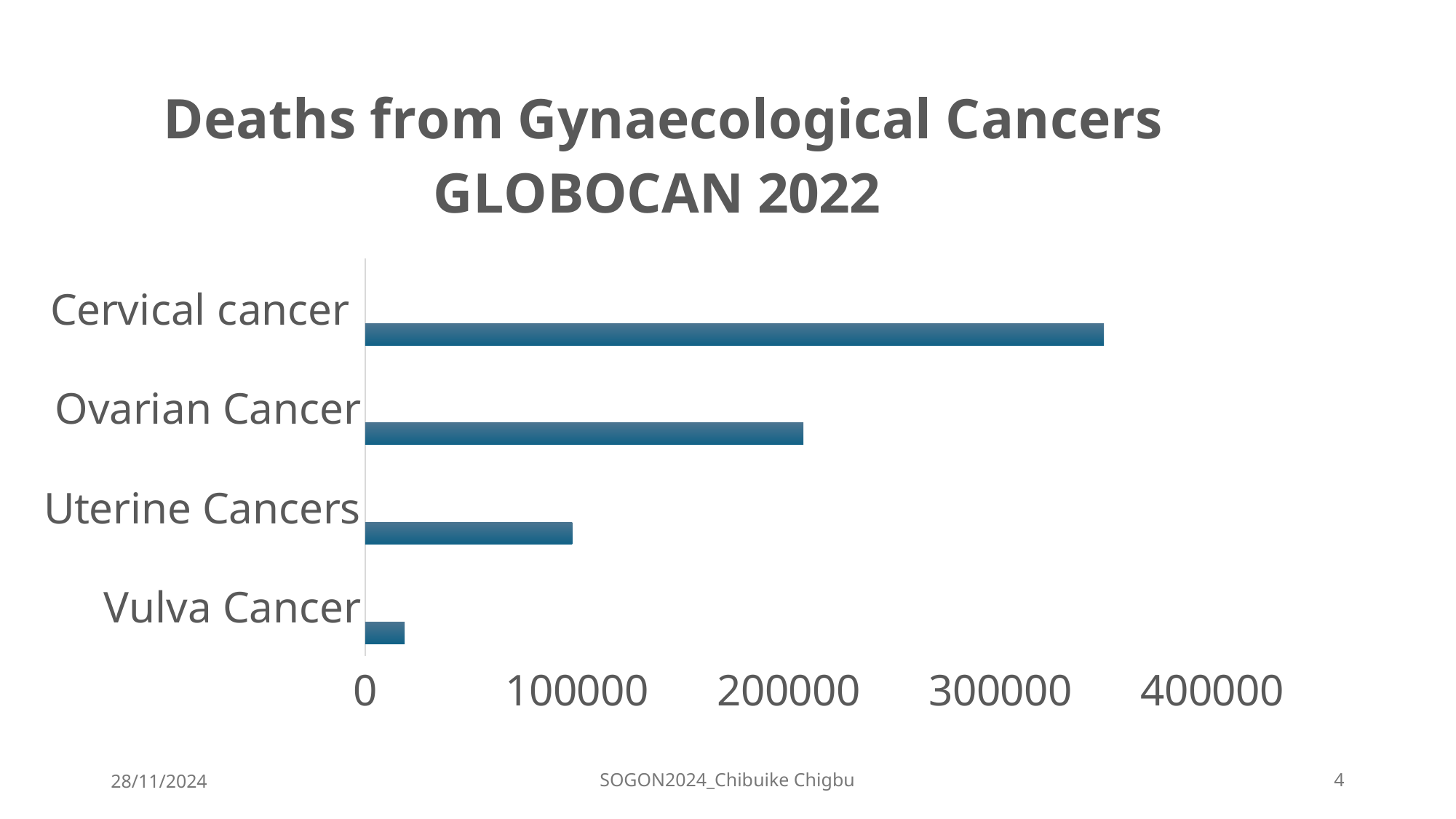
Which has fewer deaths, Vulva Cancer or Cervical cancer? Vulva Cancer Is the value for Ovarian Cancer greater or less than 100000? greater What is the title of the chart? Deaths from Gynaecological Cancers GLOBOCAN 2022 Which has more deaths, Ovarian Cancer or Uterine Cancers? Ovarian Cancer Which cancer has the lowest number of deaths in the chart? Vulva Cancer Which cancer has the highest number of deaths in the chart? Cervical cancer Is the value for Uterine Cancers greater or less than 200000? less Is the value for Vulva Cancer greater or less than 100000? less What type of chart is shown on the slide? bar chart How many cancer categories are plotted in the chart? 4